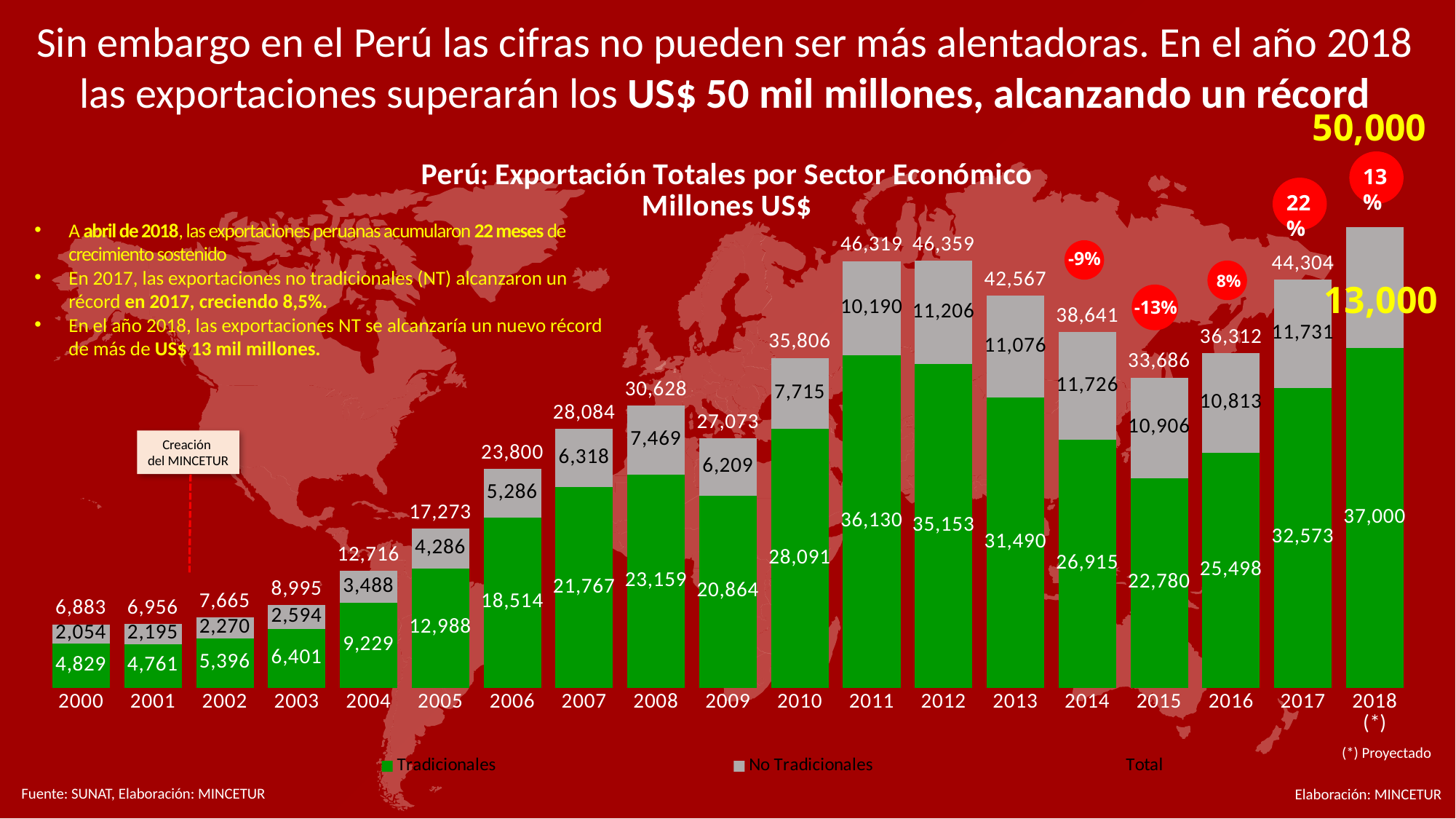
Which year has the lowest total export value? 2000 What is the No Tradicionales value for 2017? 11,731 How many years are shown on the x axis? 19 Do the total export values rise or fall from 2000 to 2008? Rise What is the title of the chart? Perú: Exportación Totales por Sector Económico Millones US$ How many entries does the legend list? 3 Which year has the highest Tradicionales value? 2018 (*) What is the Tradicionales value for 2011? 36,130 What is the difference between the total for 2017 and the total for 2016? 7,992 Which is larger, the Tradicionales value for 2011 or for 2012? 2011 What kind of chart is shown? Stacked bar chart What is the total export value shown for 2018 (*)? 50,000